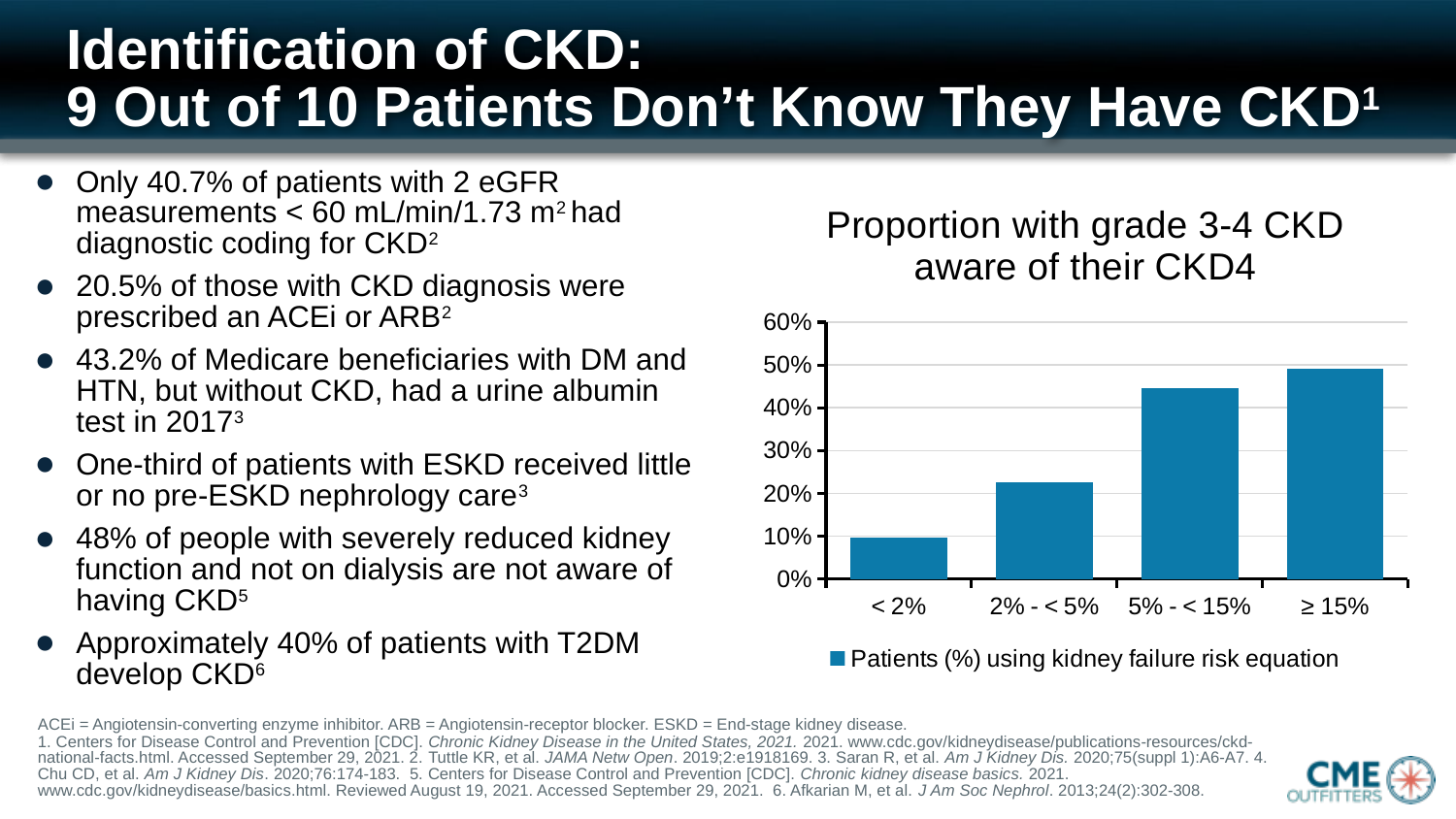
Is the value for the 5% - < 15% category greater or less than 40%? greater Which is larger, the value for 2% - < 5% or the value for 5% - < 15%? 5% - < 15% How many categories are shown on the x axis of the chart? 4 Which category has the lowest proportion of patients aware of their CKD? < 2% How many series does the chart legend list? 1 Which category has the highest proportion of patients aware of their CKD? ≥ 15% What is the title of the chart? Proportion with grade 3-4 CKD aware of their CKD4 Is the value for the 2% - < 5% category greater or less than 20%? greater Is the value for the < 2% category greater or less than 20%? less Do the values rise or fall moving from left to right along the x axis? rise What kind of chart is shown on the slide? bar chart